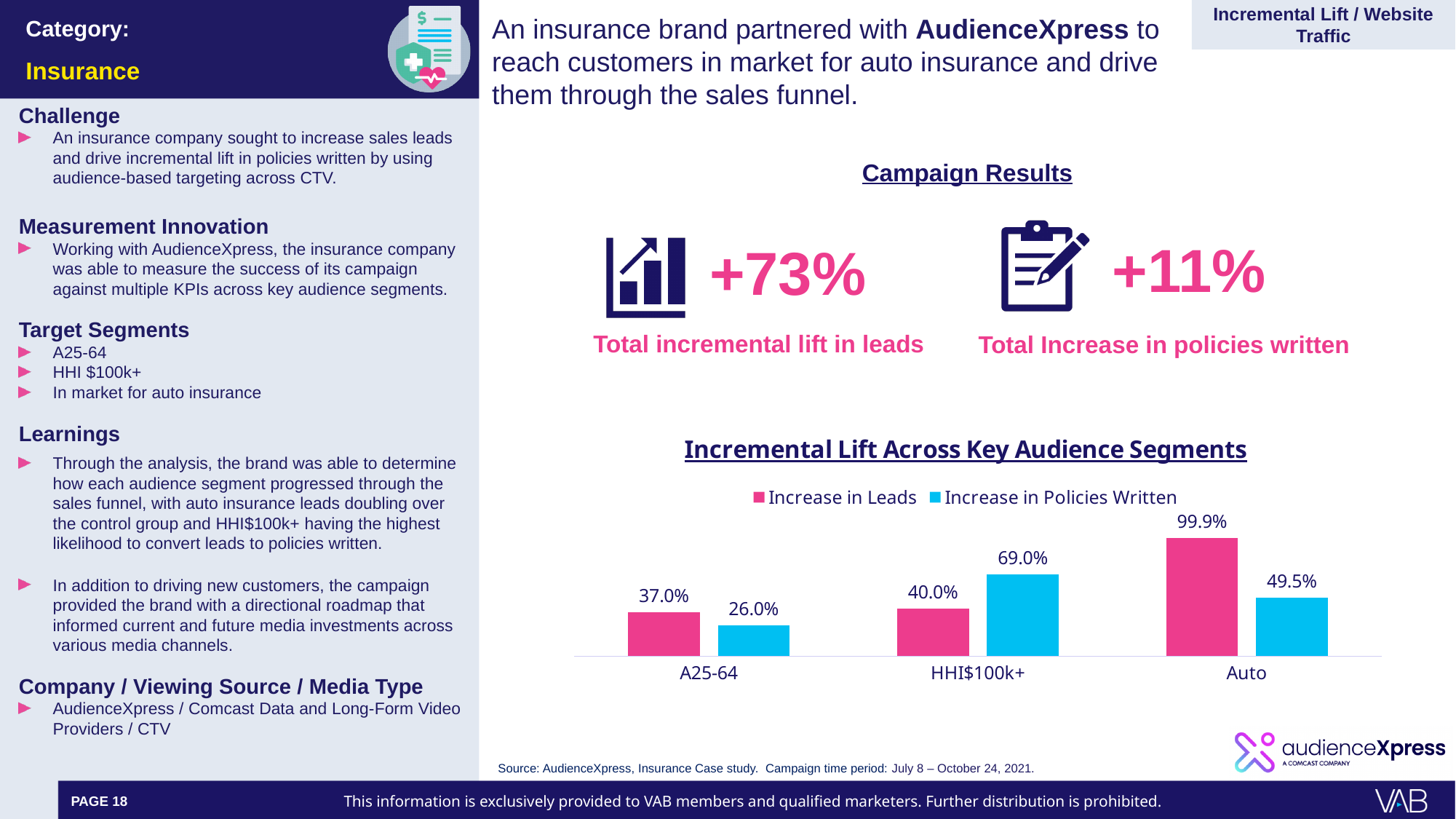
What is the Increase in Leads value for the Auto segment? 99.9% How many series does the chart legend list? 2 What is the difference between Increase in Leads and Increase in Policies Written for the Auto segment? 50.4% What kind of chart is 'Incremental Lift Across Key Audience Segments'? Bar chart Does the Increase in Leads series rise or fall from A25-64 to Auto? Rise Which segment has the lowest Increase in Policies Written? A25-64 What is the title of the chart on the slide? Incremental Lift Across Key Audience Segments Which segment has the highest Increase in Leads? Auto For HHI$100k+, which is larger: Increase in Leads or Increase in Policies Written? Increase in Policies Written What is the Increase in Policies Written value for HHI$100k+? 69.0% How many audience segments are shown on the x axis of the chart? 3 What is the Increase in Leads value for A25-64? 37.0%